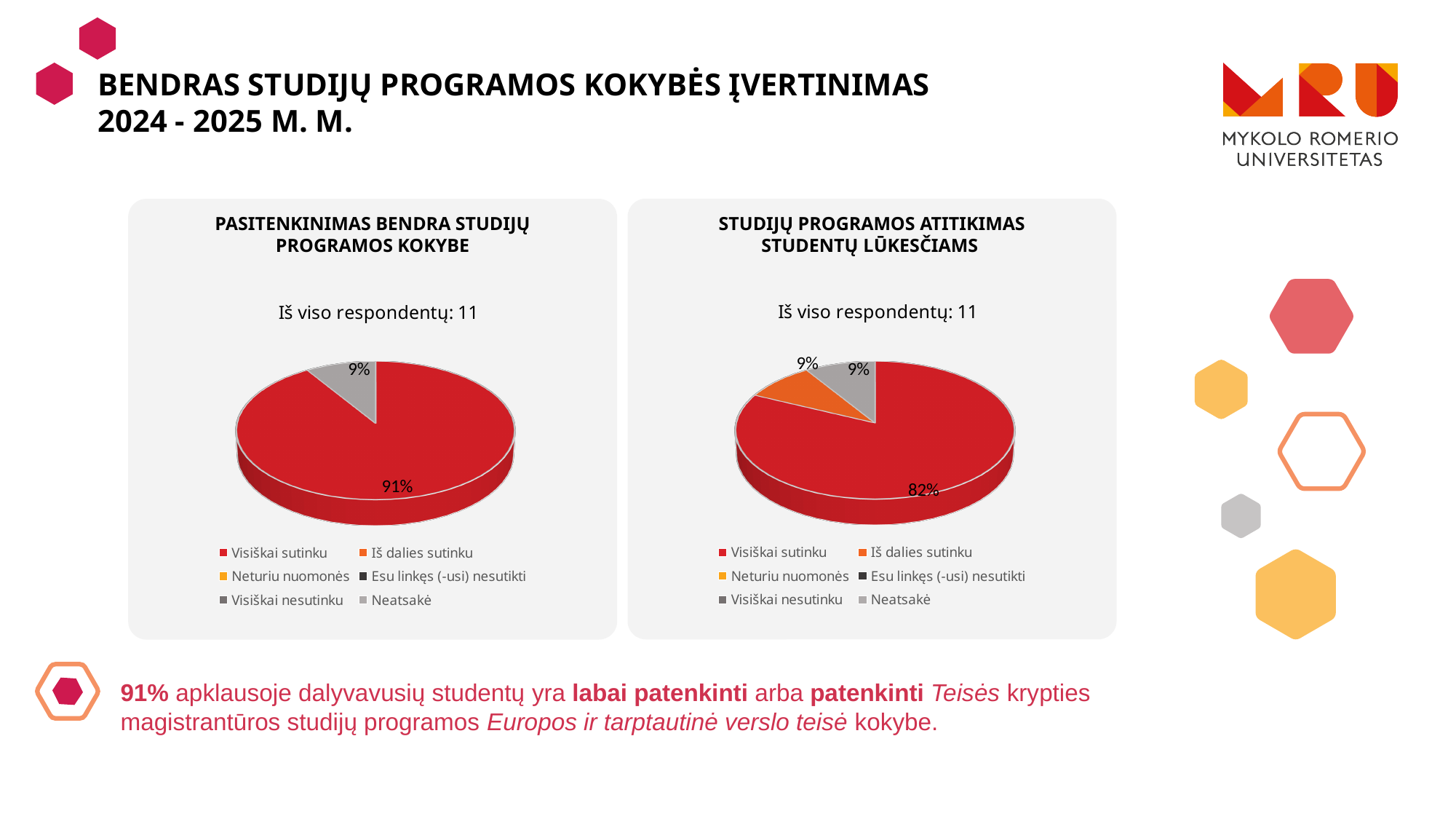
In the right chart (Studijų programos atitikimas studentų lūkesčiams), what share does the orange slice ("Iš dalies sutinku") represent? 9% In the right chart (Studijų programos atitikimas studentų lūkesčiams), which response category has the largest share? Visiškai sutinku What type of chart is used on the left (Pasitenkinimas bendra studijų programos kokybe)? Pie chart In the left chart (Pasitenkinimas bendra studijų programos kokybe), what share of respondents chose "Visiškai sutinku"? 91% What is the difference between the "Visiškai sutinku" share in the left chart (91%) and in the right chart (82%)? 9 percentage points How many respondents in total are reported for the right chart (Studijų programos atitikimas studentų lūkesčiams)? 11 Which chart has the larger "Visiškai sutinku" share: the left chart (Pasitenkinimas bendra studijų programos kokybe) or the right chart (Studijų programos atitikimas studentų lūkesčiams)? The left chart (Pasitenkinimas bendra studijų programos kokybe) In the right chart (Studijų programos atitikimas studentų lūkesčiams), what share of respondents chose "Visiškai sutinku"? 82% How many slices are shown in the left chart (Pasitenkinimas bendra studijų programos kokybe)? 2 How many slices are shown in the right chart (Studijų programos atitikimas studentų lūkesčiams)? 3 In the left chart (Pasitenkinimas bendra studijų programos kokybe), what share does the grey slice represent? 9% How many entries does the legend of the left chart (Pasitenkinimas bendra studijų programos kokybe) list? 6